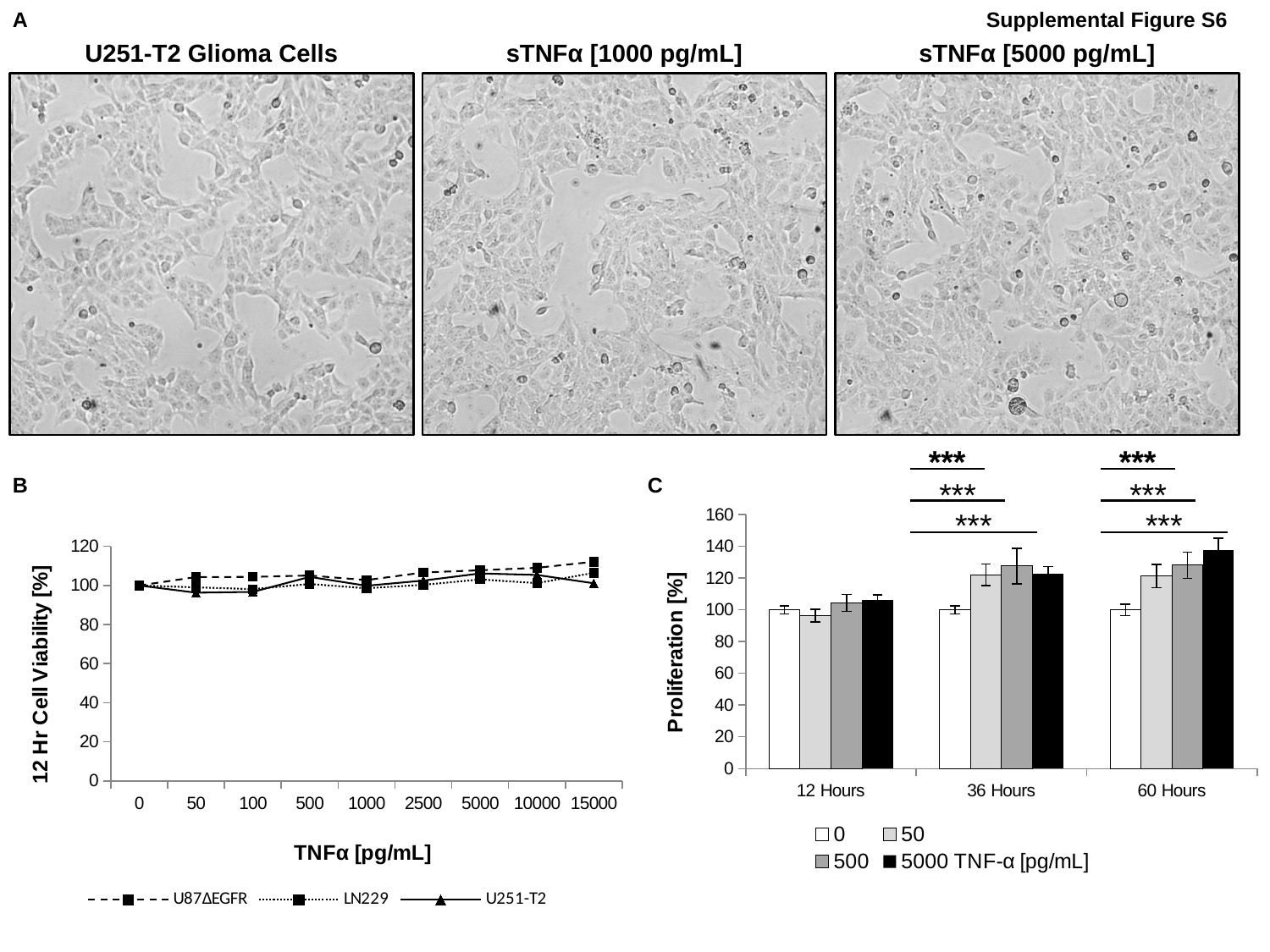
In chart C, which is larger: the 5000 TNF-α bar at 36 Hours or the 5000 TNF-α bar at 60 Hours? 60 Hours In chart C, is the value for 5000 TNF-α at 60 Hours greater or less than 120? greater What kind of chart is chart B (the left chart)? line chart In chart C, how many series does the legend list? 4 In chart B, is the value for U87ΔEGFR at 15000 pg/mL greater or less than 100? greater In chart C, is the value for 50 TNF-α at 12 Hours greater or less than 120? less In chart C, does the 5000 TNF-α series rise or fall from 12 Hours to 60 Hours? rise In chart C, how many time points are shown on the x axis? 3 What is the y-axis title of chart C? Proliferation [%] What kind of chart is chart C (the right chart)? bar chart In chart B, how many TNFα concentrations are shown on the x axis? 9 In chart B, how many series does the legend list? 3